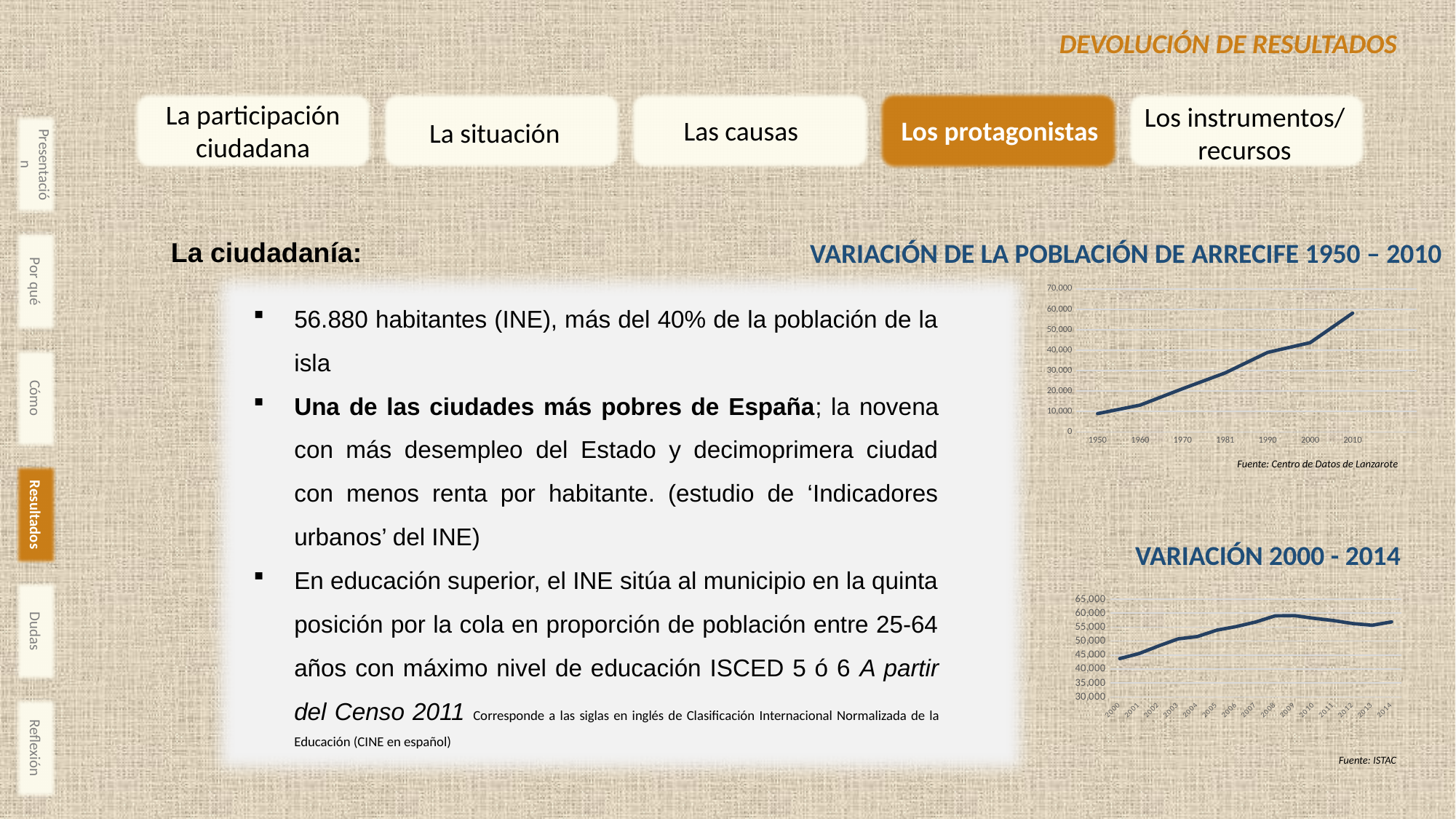
In the 'VARIACIÓN DE LA POBLACIÓN DE ARRECIFE 1950 – 2010' chart, is the value for 2010 greater or less than 50,000? greater In the 'VARIACIÓN DE LA POBLACIÓN DE ARRECIFE 1950 – 2010' chart, which year has the lowest value? 1950 What is the source cited under the 'VARIACIÓN DE LA POBLACIÓN DE ARRECIFE 1950 – 2010' chart? Centro de Datos de Lanzarote In the 'VARIACIÓN DE LA POBLACIÓN DE ARRECIFE 1950 – 2010' chart, do the values rise or fall from 1950 to 2010? rise How many years are marked on the x axis of the 'VARIACIÓN 2000 - 2014' chart? 15 In the 'VARIACIÓN DE LA POBLACIÓN DE ARRECIFE 1950 – 2010' chart, which year has the highest value? 2010 What kind of chart is the 'VARIACIÓN DE LA POBLACIÓN DE ARRECIFE 1950 – 2010' chart? line chart What kind of chart is the 'VARIACIÓN 2000 - 2014' chart? line chart In the 'VARIACIÓN 2000 - 2014' chart, which is larger, the value for 2008 or the value for 2000? 2008 How many years are marked on the x axis of the 'VARIACIÓN DE LA POBLACIÓN DE ARRECIFE 1950 – 2010' chart? 7